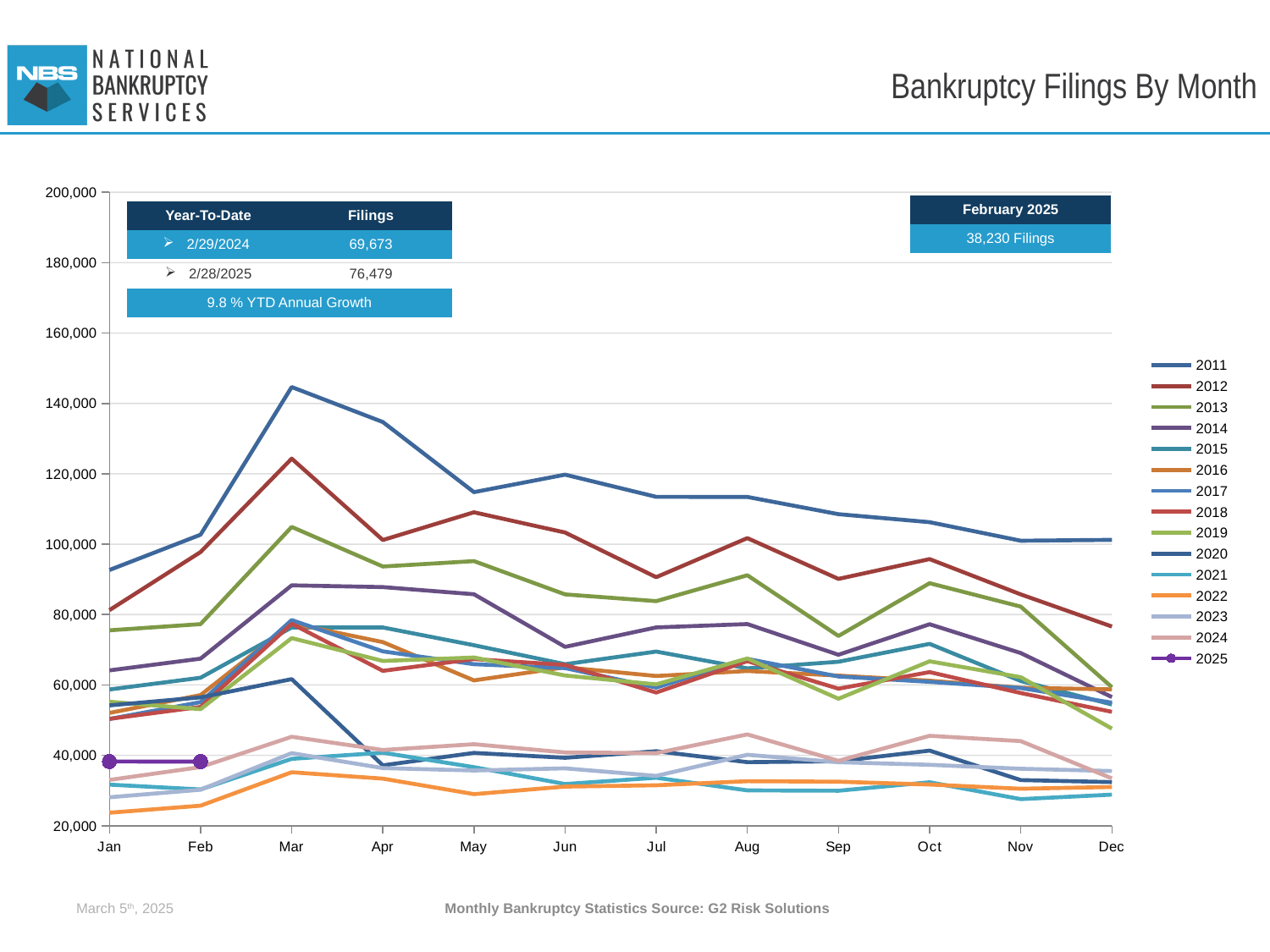
In January, which is larger: the value for 2011 or the value for 2022? 2011 How many series does the legend list? 15 Is the value for 2022 in January greater or less than 40,000? less What is the difference between the year-to-date filings as of 2/28/2025 and as of 2/29/2024? 6,806 How many bankruptcy filings were there in February 2025, according to the slide? 38,230 Which year's line is highest in March? 2011 Which year's line is lowest in January? 2022 What kind of chart is shown on the slide? line chart What YTD annual growth percentage is stated on the slide? 9.8 % What were the year-to-date filings as of 2/28/2025? 76,479 How many months are shown along the x axis? 12 Is the value for 2011 in March greater or less than 140,000? greater